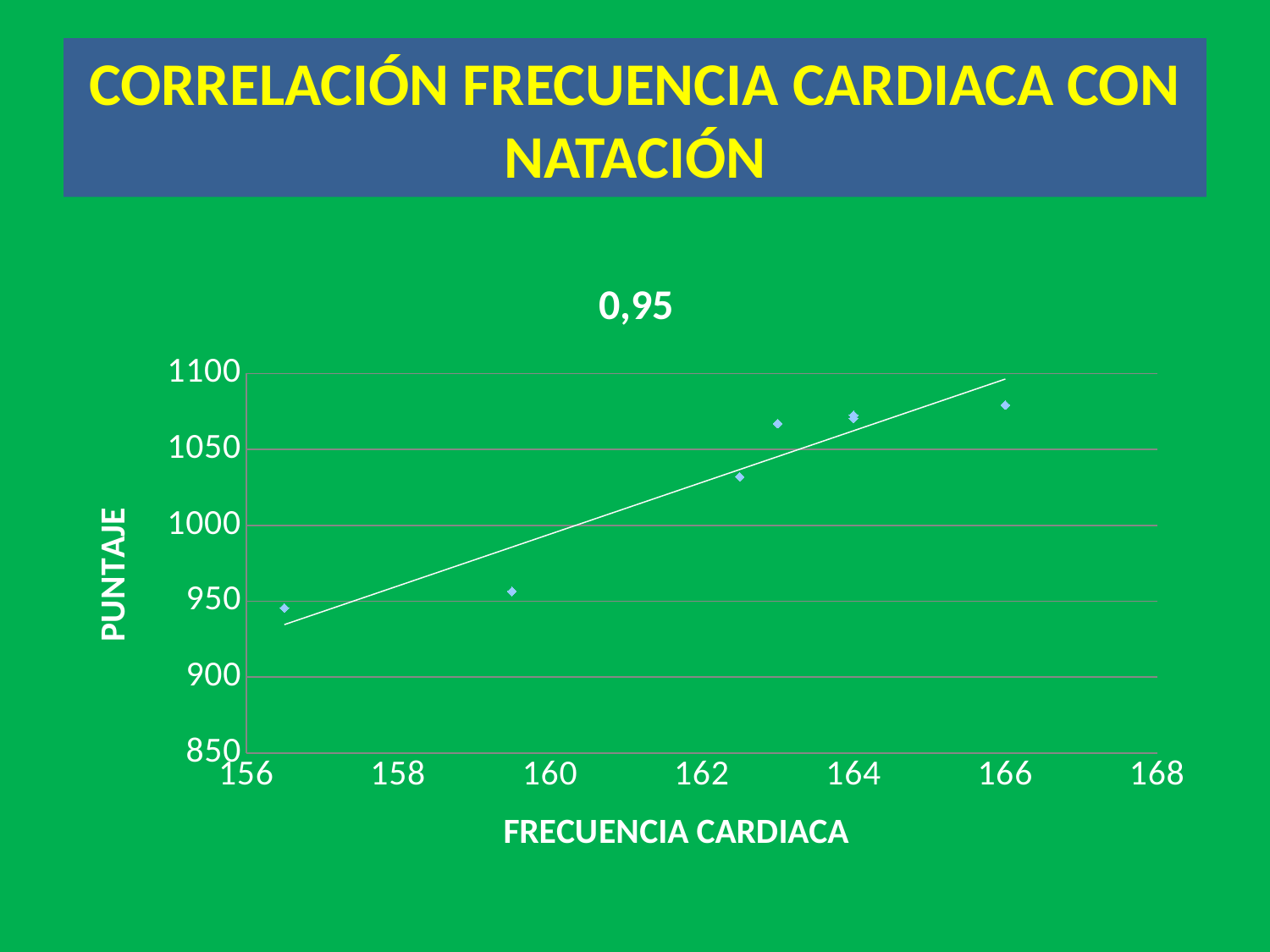
Is the PUNTAJE value for the point at a heart rate of about 163 greater or less than 1050? greater Is the PUNTAJE value for the point at a heart rate of about 166 greater or less than 1050? greater Is the PUNTAJE value for the point at a heart rate of about 159.5 greater or less than 1000? less What is the lowest value shown on the vertical axis of the chart? 850 Do the PUNTAJE values rise or fall as FRECUENCIA CARDIACA increases along the x axis? rise Which point has the lowest PUNTAJE value: the one at a heart rate of about 156.5 or the one at about 166? the one at about 156.5 What kind of chart is shown on the slide? scatter chart Which point has a higher PUNTAJE value: the one at a heart rate of about 159.5 or the one at about 162.5? the one at about 162.5 What is the label of the vertical axis of the chart? PUNTAJE What is the title shown above the chart? 0,95